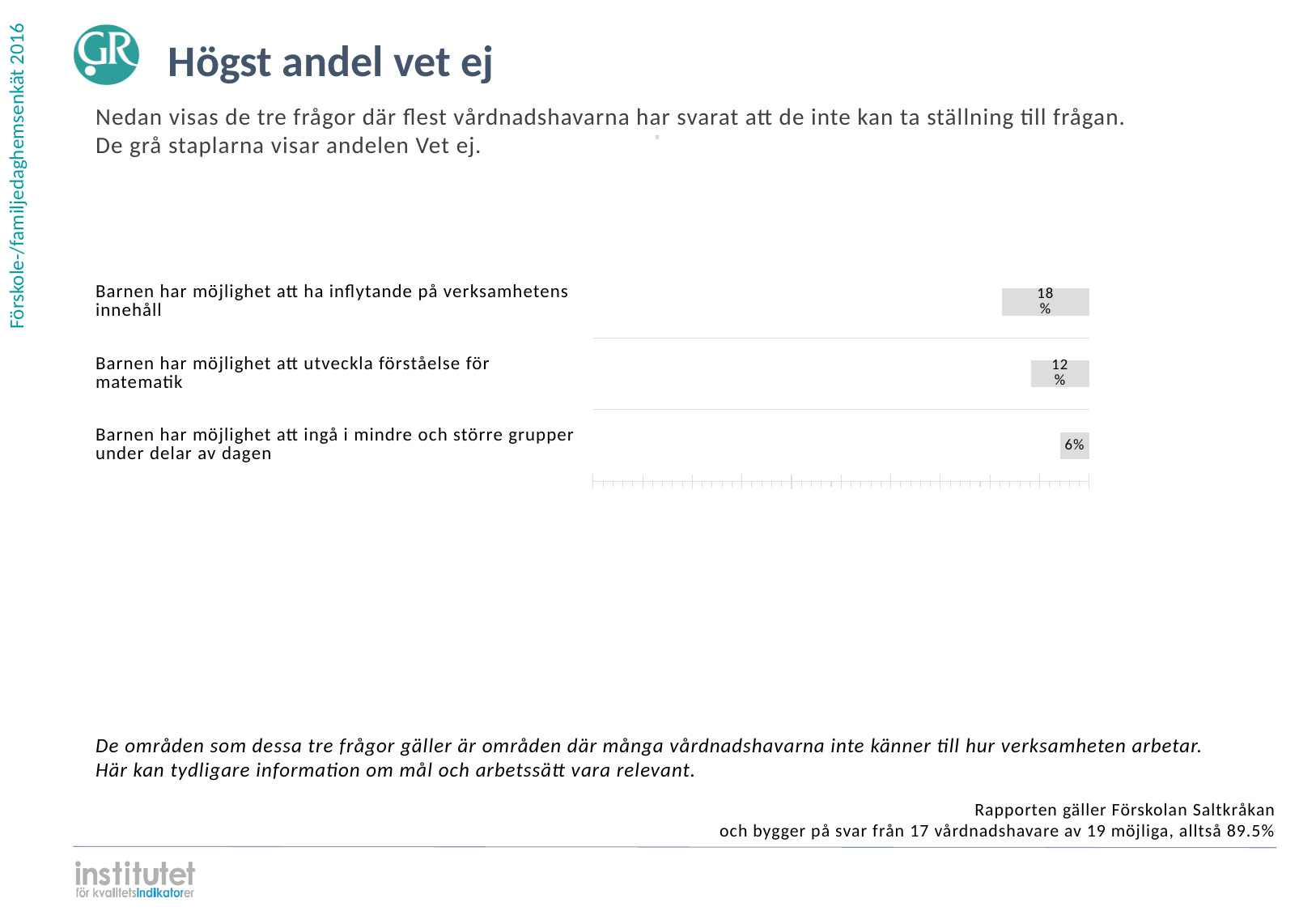
What is the Vet ej share for "Barnen har möjlighet att utveckla förståelse för matematik"? 12% What is the difference in Vet ej share between "Barnen har möjlighet att ha inflytande på verksamhetens innehåll" and "Barnen har möjlighet att utveckla förståelse för matematik"? 6 percentage points How many questions (categories) are shown in the chart? 3 What is the Vet ej share for "Barnen har möjlighet att ingå i mindre och större grupper under delar av dagen"? 6% What is the title of the slide containing the chart? Högst andel vet ej What is the Vet ej share for "Barnen har möjlighet att ha inflytande på verksamhetens innehåll"? 18% Which question has the highest Vet ej share? Barnen har möjlighet att ha inflytande på verksamhetens innehåll What colour are the bars in the chart? Grey Which question has the lowest Vet ej share? Barnen har möjlighet att ingå i mindre och större grupper under delar av dagen What is the difference in Vet ej share between "Barnen har möjlighet att utveckla förståelse för matematik" and "Barnen har möjlighet att ingå i mindre och större grupper under delar av dagen"? 6 percentage points Which has a larger Vet ej share: "Barnen har möjlighet att utveckla förståelse för matematik" or "Barnen har möjlighet att ingå i mindre och större grupper under delar av dagen"? Barnen har möjlighet att utveckla förståelse för matematik What kind of chart is shown on the slide? Bar chart